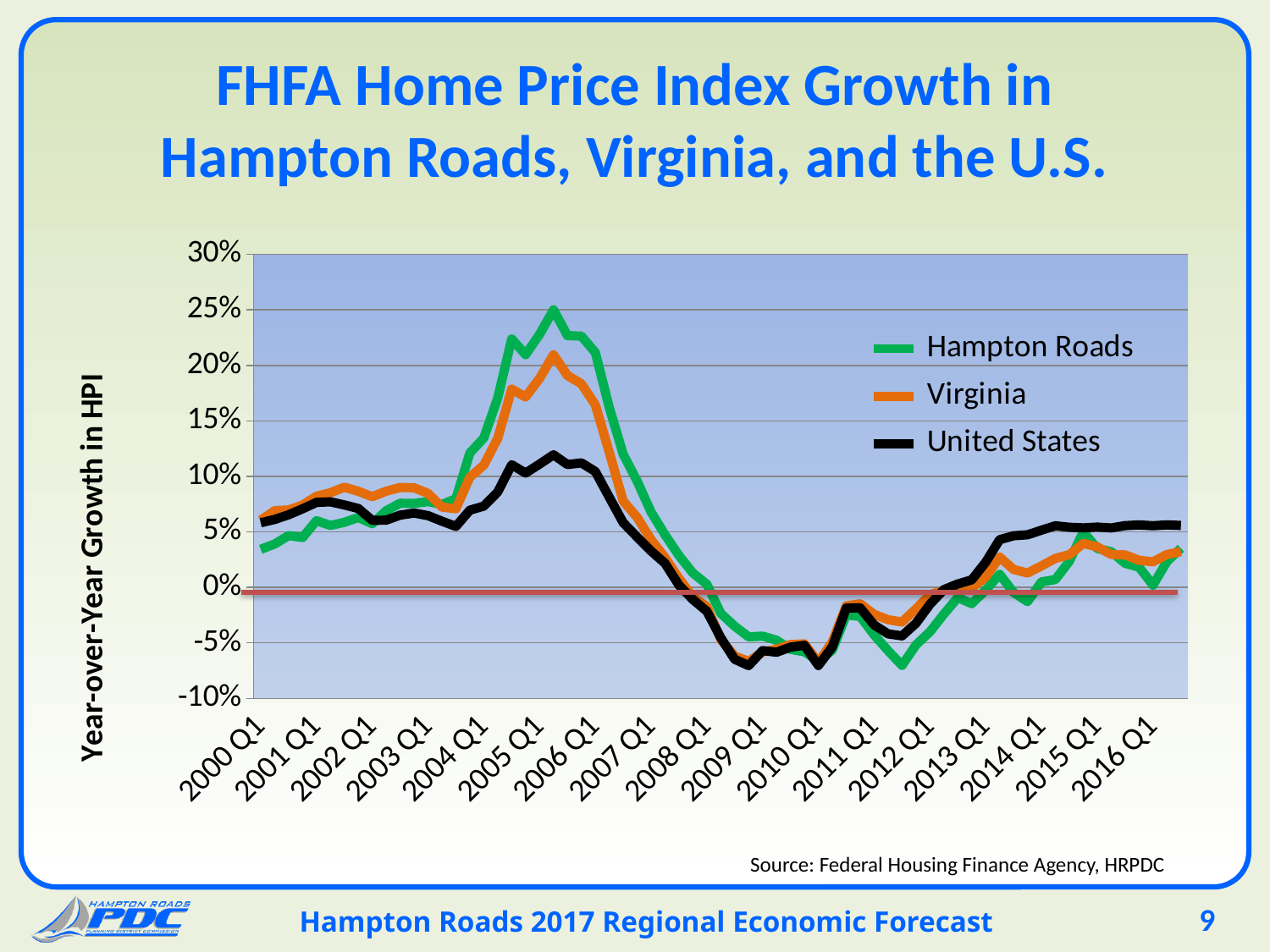
Which series is drawn in green in the chart? Hampton Roads What is the label on the vertical axis of the chart? Year-over-Year Growth in HPI Does the Hampton Roads line rise or fall between 2006 Q1 and 2009 Q1? fall How many series does the legend list? 3 Is the peak value for Hampton Roads around 2005 greater or less than 20%? greater At the 2005 peak, which series is larger, Hampton Roads or United States? Hampton Roads What kind of chart is shown on the slide? line chart How many year labels are shown along the x axis? 17 Around 2014 Q1, which series is larger, United States or Hampton Roads? United States Which series reaches the highest peak in the chart? Hampton Roads Is the lowest value for Hampton Roads around 2012 Q1 greater or less than -5%? less Is the peak value for United States around 2005 greater or less than 15%? less